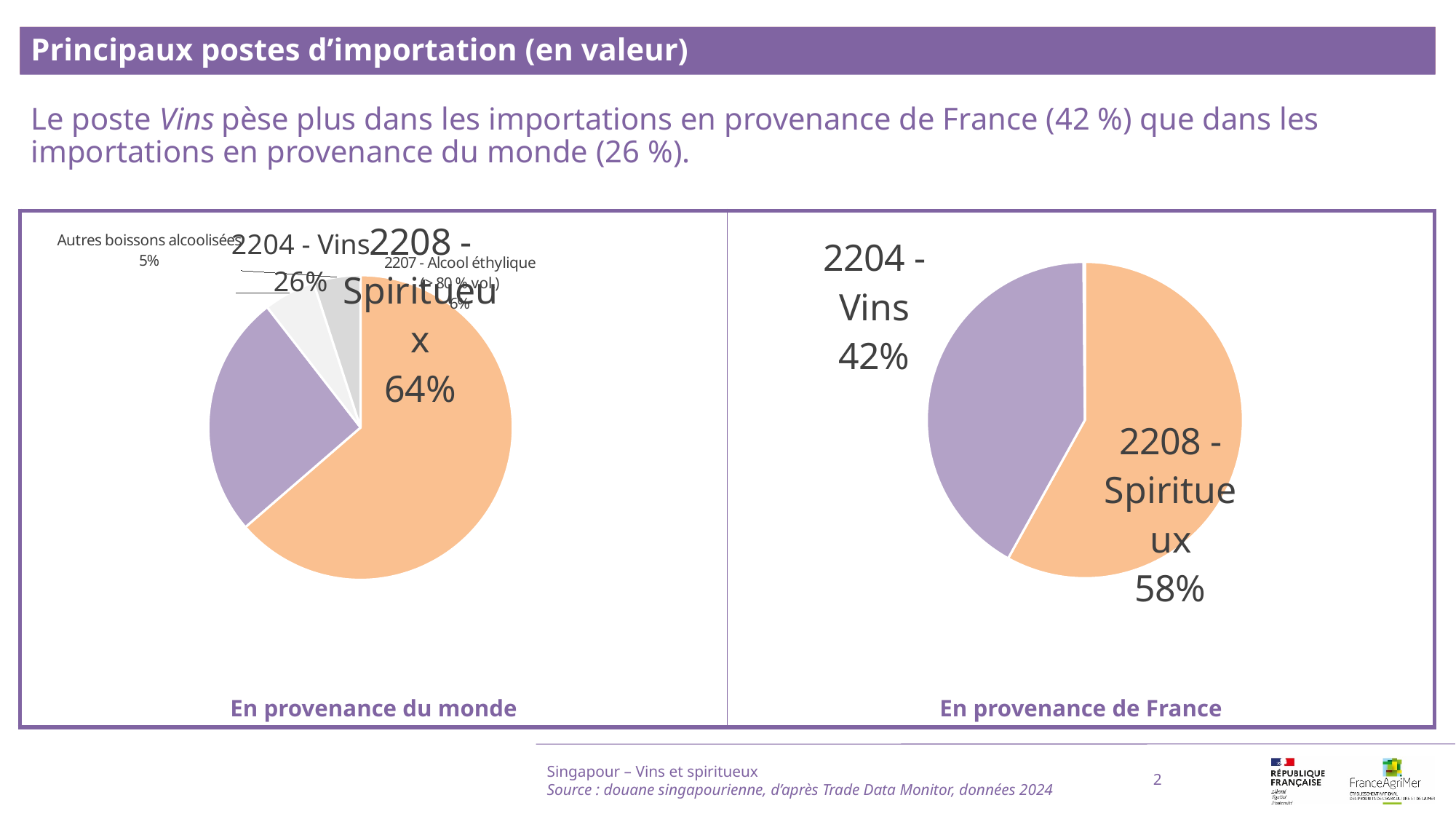
In the 'En provenance de France' chart, what share does 2208 - Spiritueux have? 58% In the 'En provenance du monde' chart, what share does Autres boissons alcoolisées have? 5% How many slices does the 'En provenance de France' chart have? 2 In the 'En provenance du monde' chart, which category has the smallest slice? Autres boissons alcoolisées In the 'En provenance du monde' chart, what is the difference between the 2208 - Spiritueux share and the 2204 - Vins share? 38% In the 'En provenance du monde' chart, what share does 2204 - Vins have? 26% In the 'En provenance du monde' chart, which category has the largest slice? 2208 - Spiritueux What kind of chart is the 'En provenance du monde' chart? Pie chart In the 'En provenance de France' chart, what is the difference between the 2208 - Spiritueux share and the 2204 - Vins share? 16% In the 'En provenance de France' chart, which category has the largest slice? 2208 - Spiritueux